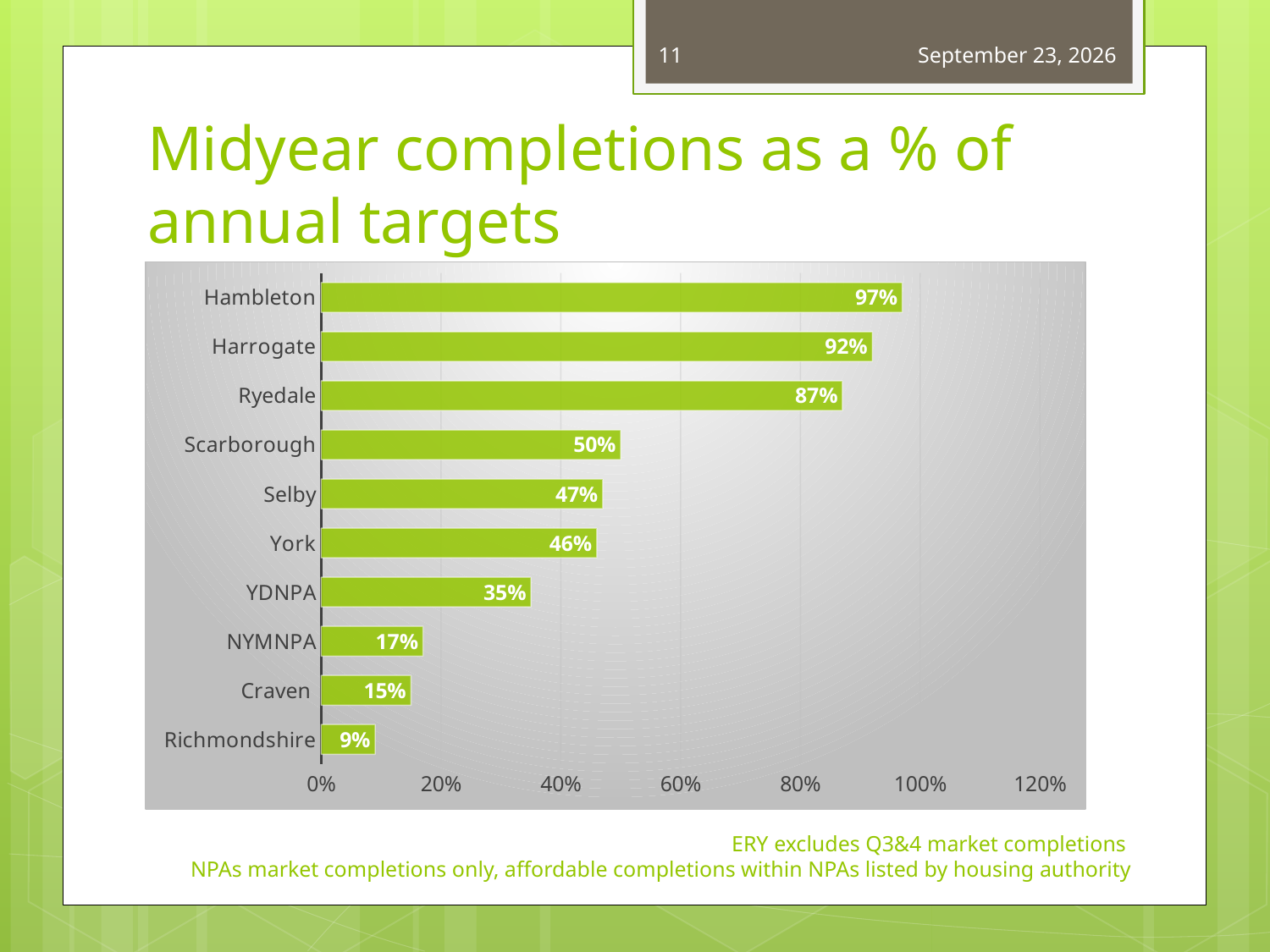
Which is larger, the value for Selby or the value for York? Selby Is the value for Ryedale greater or less than 80%? greater What is the value for Craven? 15% How many categories are shown in the chart? 10 Which category has the highest value? Hambleton Which category has the lowest value? Richmondshire What is the title of the slide containing the chart? Midyear completions as a % of annual targets What is the difference between the values for YDNPA and NYMNPA? 18% What is the difference between the values for Harrogate and Ryedale? 5% What is the value for Hambleton? 97% What is the value for Scarborough? 50% What kind of chart is shown on the slide? Bar chart